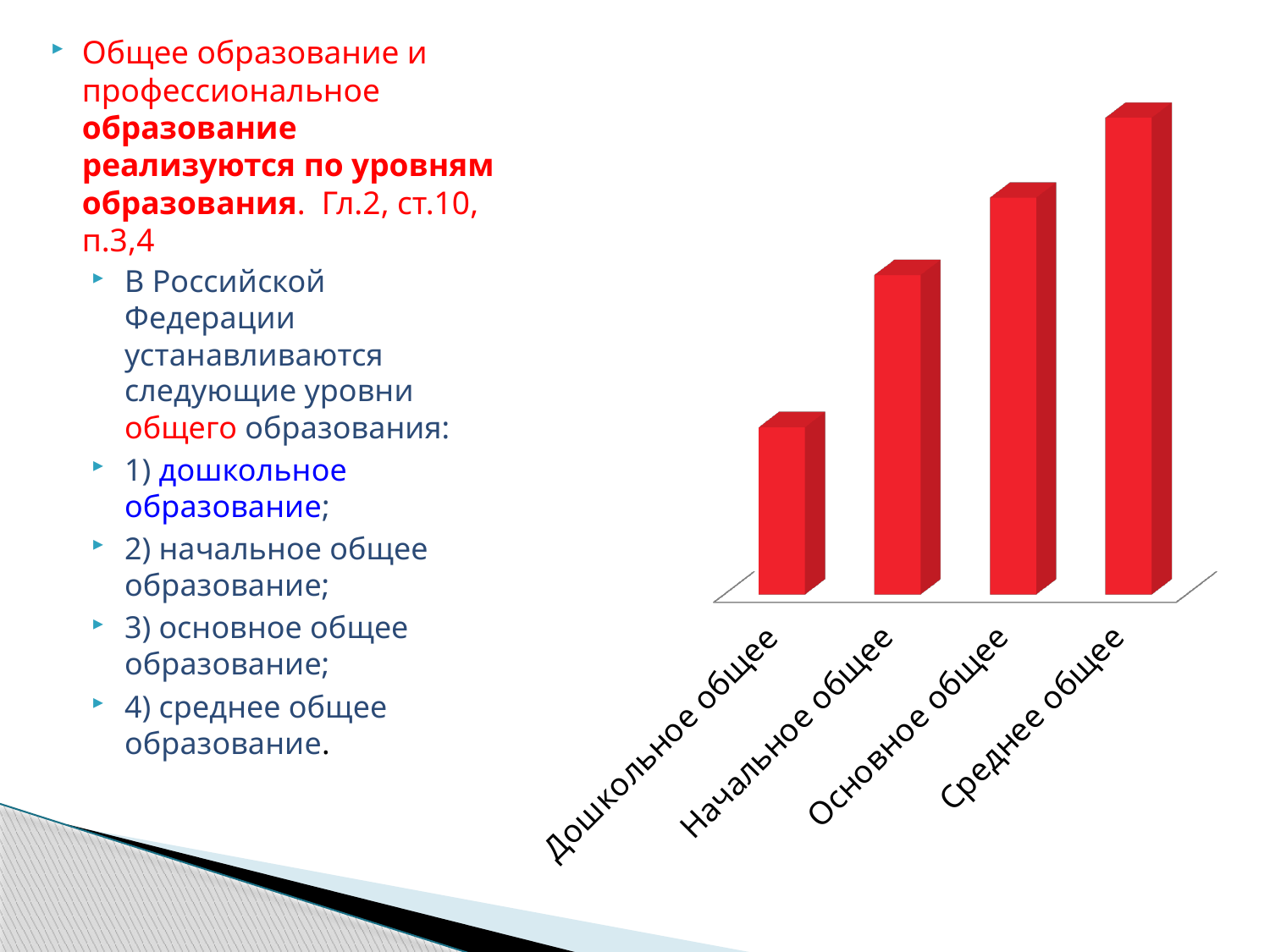
Which bar is taller: Дошкольное общее or Среднее общее? Среднее общее Which bar is taller: Начальное общее or Основное общее? Основное общее Which category has the tallest bar in the chart? Среднее общее What is the first category label on the x axis of the chart? Дошкольное общее How many categories are shown on the x axis of the chart? 4 What colour are the bars in the chart? red Do the bar heights rise or fall from left to right along the x axis? rise What kind of chart is shown on the slide? bar chart Which category has the shortest bar in the chart? Дошкольное общее